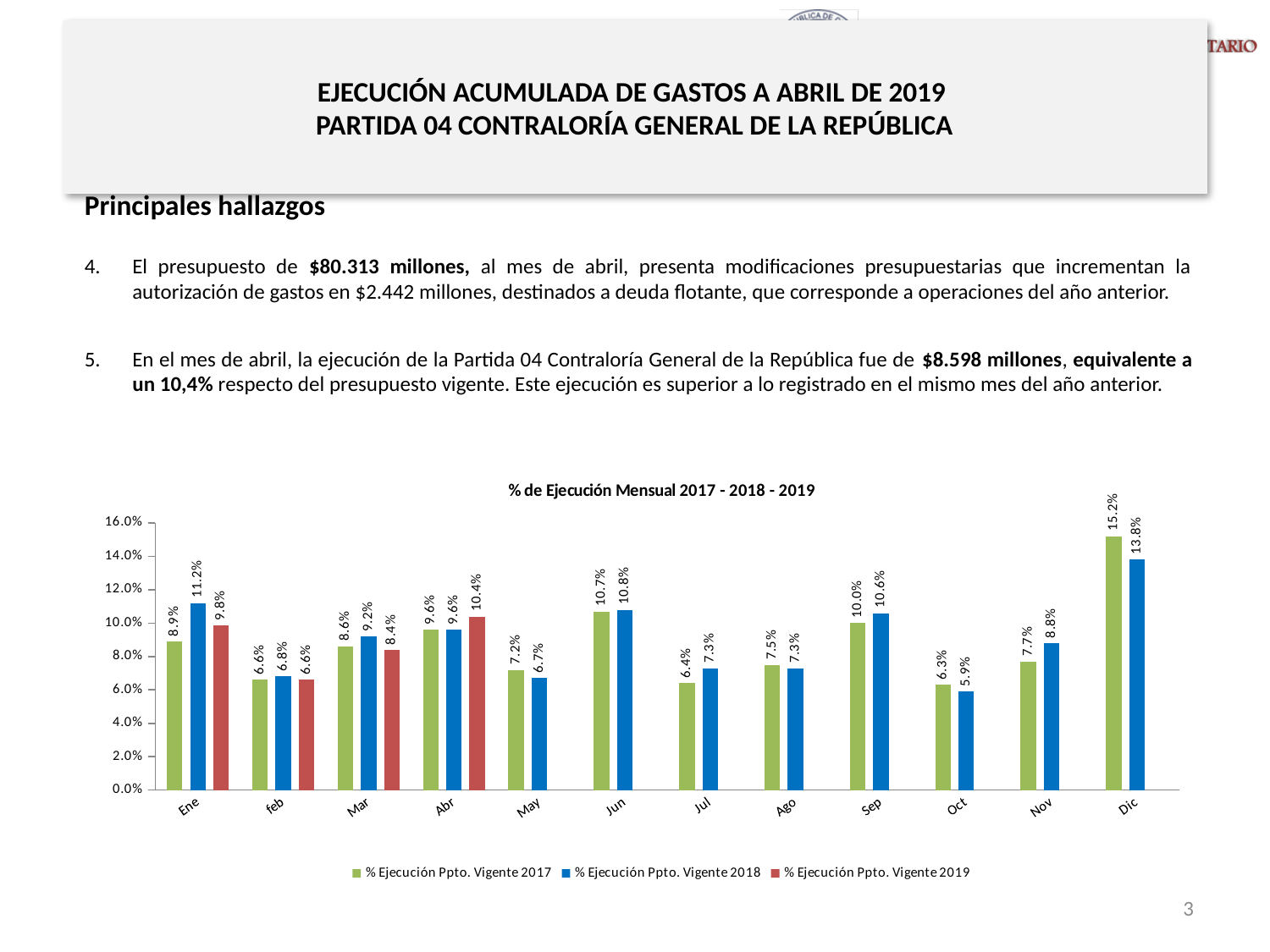
What is the difference between the 2017 and 2018 values for Dic? 1.4% What is the value for Abr in the % Ejecución Ppto. Vigente 2019 series? 10.4% What is the value for Ene in the % Ejecución Ppto. Vigente 2018 series? 11.2% Which month has the lowest value in the % Ejecución Ppto. Vigente 2017 series? Oct Which is larger for Nov: the 2017 value or the 2018 value? 2018 Which month has the highest value in the % Ejecución Ppto. Vigente 2018 series? Dic What is the value for Dic in the % Ejecución Ppto. Vigente 2017 series? 15.2% How many months are shown on the x axis? 12 What is the difference between the 2018 and 2019 values for Ene? 1.4% How many series does the legend list? 3 What kind of chart is shown on the slide? Bar chart What is the title of the chart? % de Ejecución Mensual 2017 - 2018 - 2019